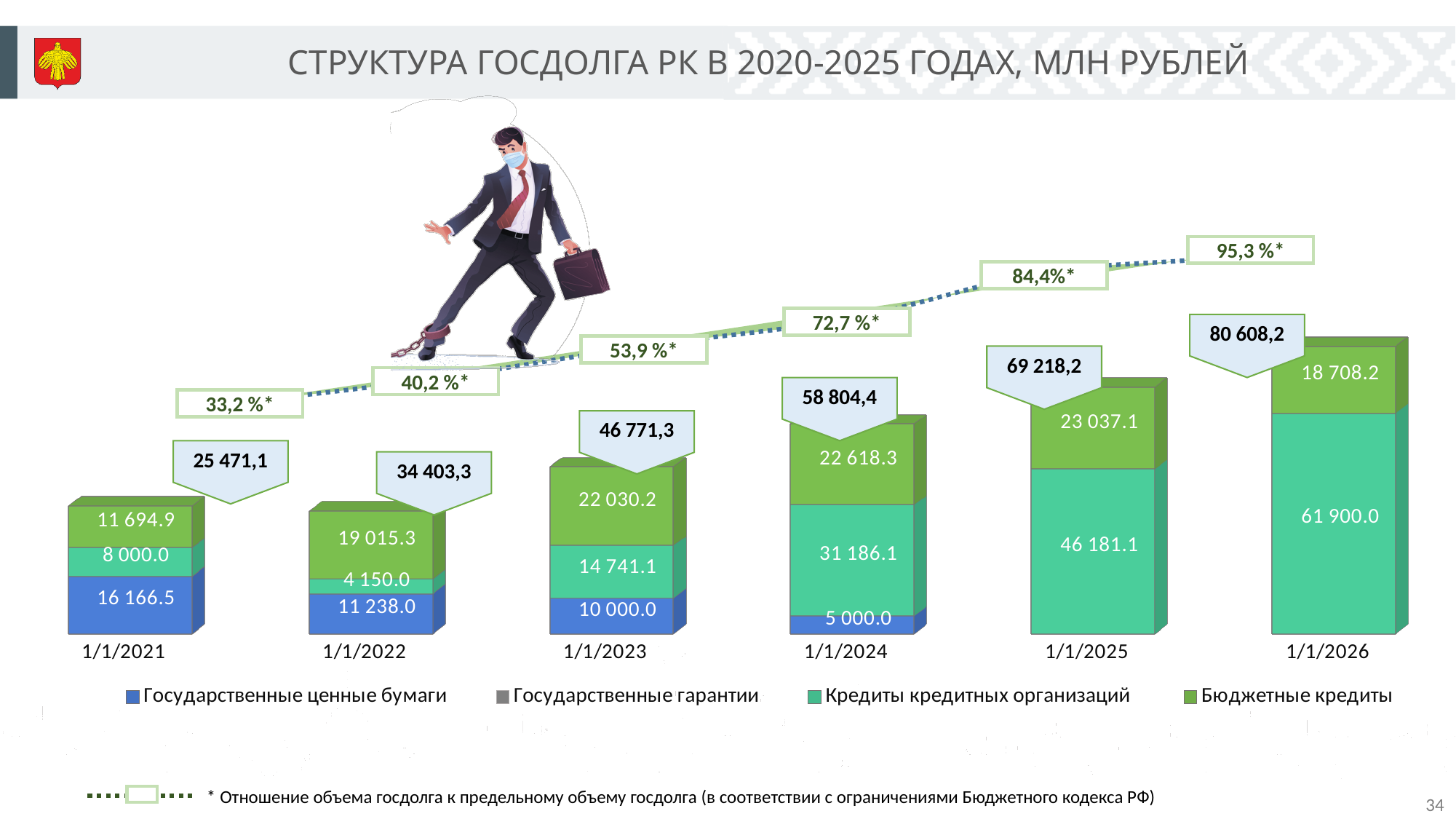
Do the total debt values rise or fall from 1/1/2021 to 1/1/2026? Rise What is the value of Государственные ценные бумаги for 1/1/2021? 16 166.5 Which date has the lowest total government debt? 1/1/2021 Which date has the highest total government debt? 1/1/2026 What is the total of the stacked bar for 1/1/2024? 58 804,4 What percentage is shown in the callout above the 1/1/2024 bar? 72,7 % What is the value of Кредиты кредитных организаций for 1/1/2025? 46 181.1 How many series does the legend list? 4 What is the value of Бюджетные кредиты for 1/1/2023? 22 030.2 How many dates (categories) are shown on the x axis? 6 What is the difference between Кредиты кредитных организаций for 1/1/2024 and for 1/1/2023? 16 445.0 What kind of chart is shown on the slide? Stacked bar chart